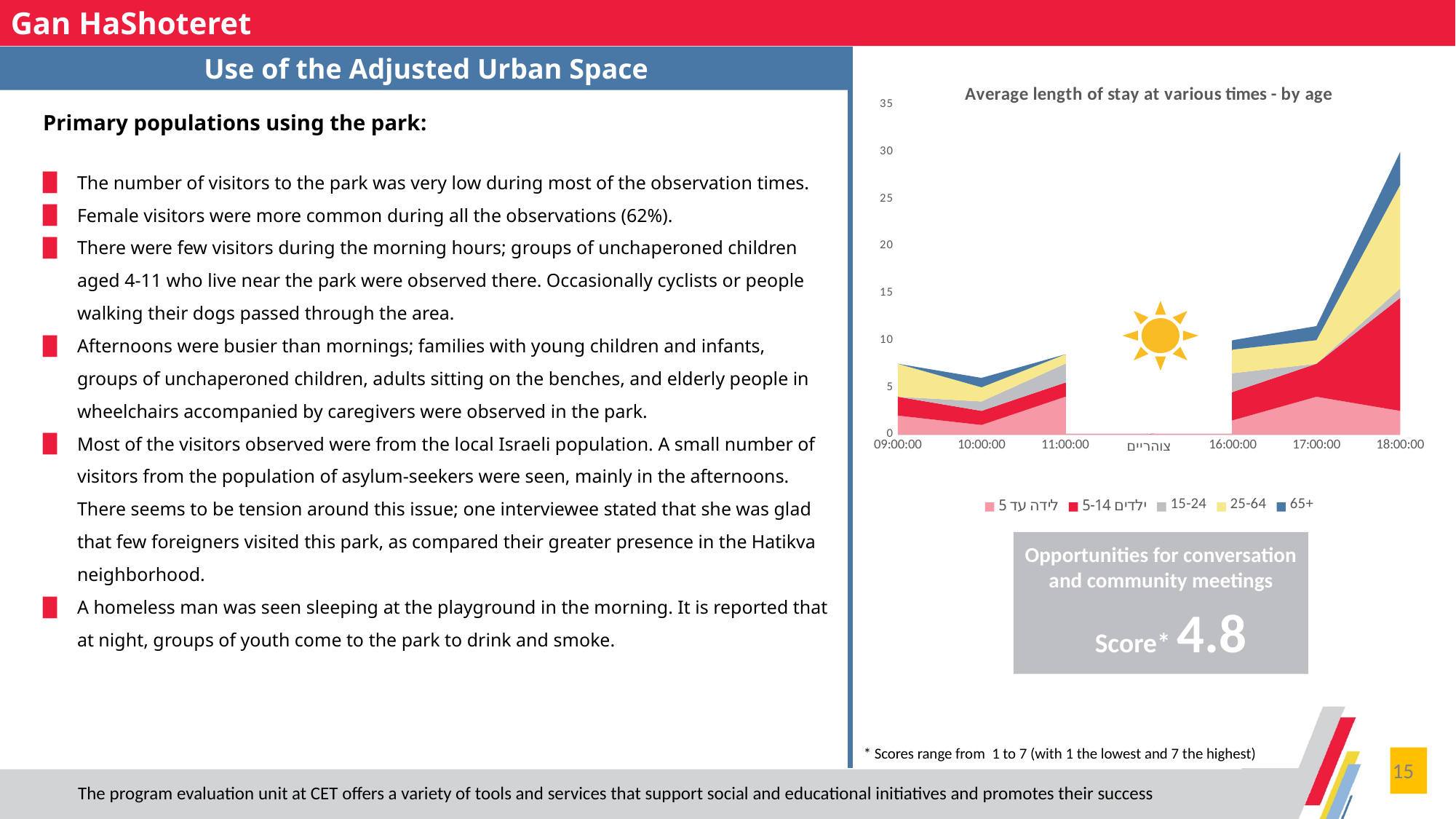
Is the total stacked value at 09:00:00 greater or less than 5? greater Is the total stacked value at 11:00:00 greater or less than 10? less Is the total stacked value at 18:00:00 greater or less than 25? greater What is the last entry in the chart legend? 65+ Which is larger, the total stacked value at 18:00:00 or at 17:00:00? 18:00:00 Does the total stacked value rise or fall from 16:00:00 to 18:00:00? rise What is the title of the chart on the slide? Average length of stay at various times - by age At which time is the total stacked value highest in the chart? 18:00:00 What kind of chart is shown on the slide? Stacked area chart How many series does the chart legend list? 5 How many time points are labelled along the x axis of the chart? 7